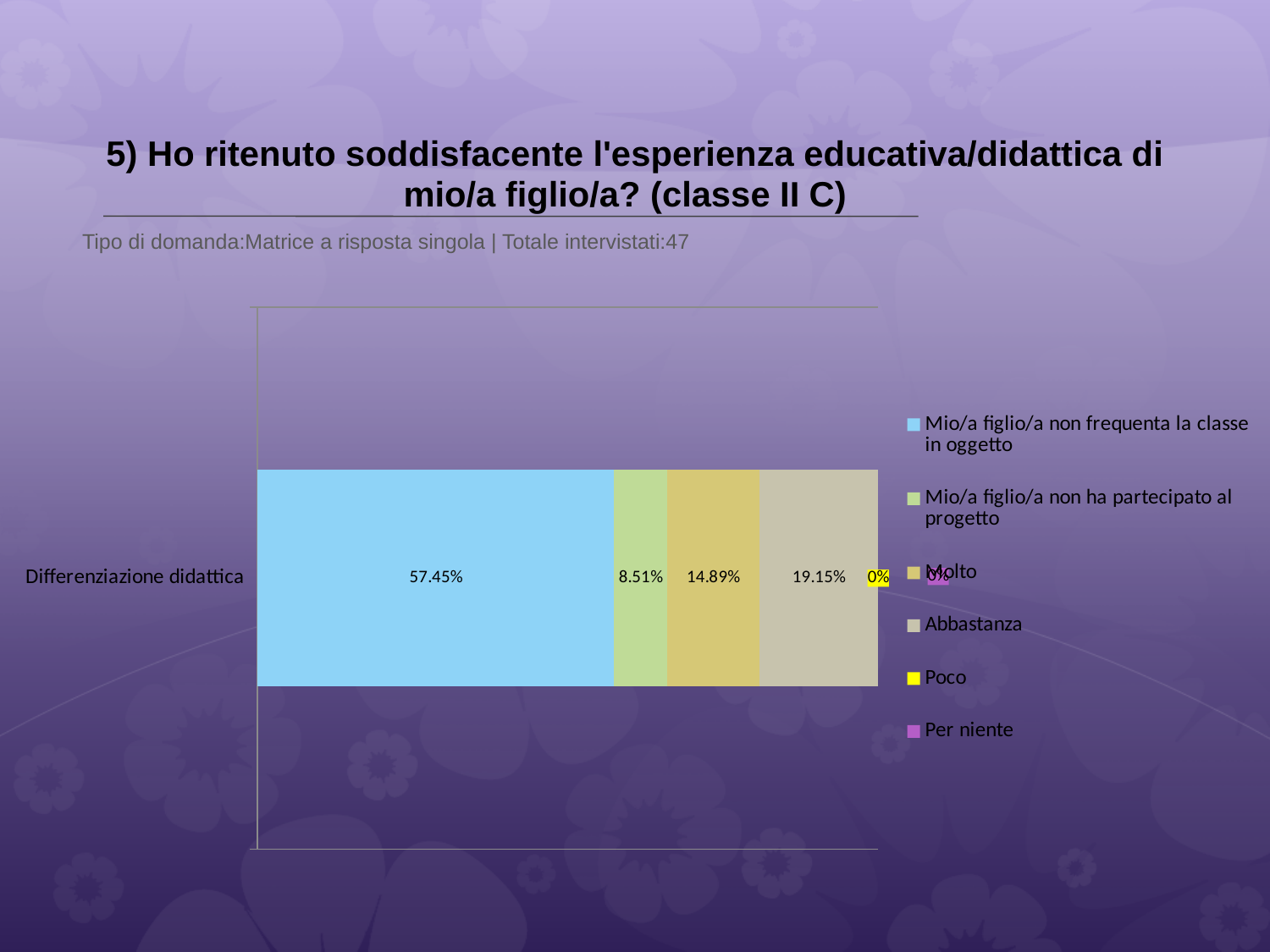
How many categories are plotted on the chart? 1 What is the value for 'Molto' for Differenziazione didattica? 14.89% What is the value for 'Poco' for Differenziazione didattica? 0% Which series has the highest value for Differenziazione didattica? Mio/a figlio/a non frequenta la classe in oggetto What is the value for 'Mio/a figlio/a non frequenta la classe in oggetto' for Differenziazione didattica? 57.45% Which is larger for Differenziazione didattica, 'Abbastanza' or 'Molto'? Abbastanza What is the label of the single category on the vertical axis? Differenziazione didattica How many series does the legend list? 6 What is the difference between the 'Abbastanza' and 'Molto' values for Differenziazione didattica? 4.26% What is the value for 'Abbastanza' for Differenziazione didattica? 19.15% What is the value for 'Mio/a figlio/a non ha partecipato al progetto' for Differenziazione didattica? 8.51% What kind of chart is shown on the slide? stacked bar chart